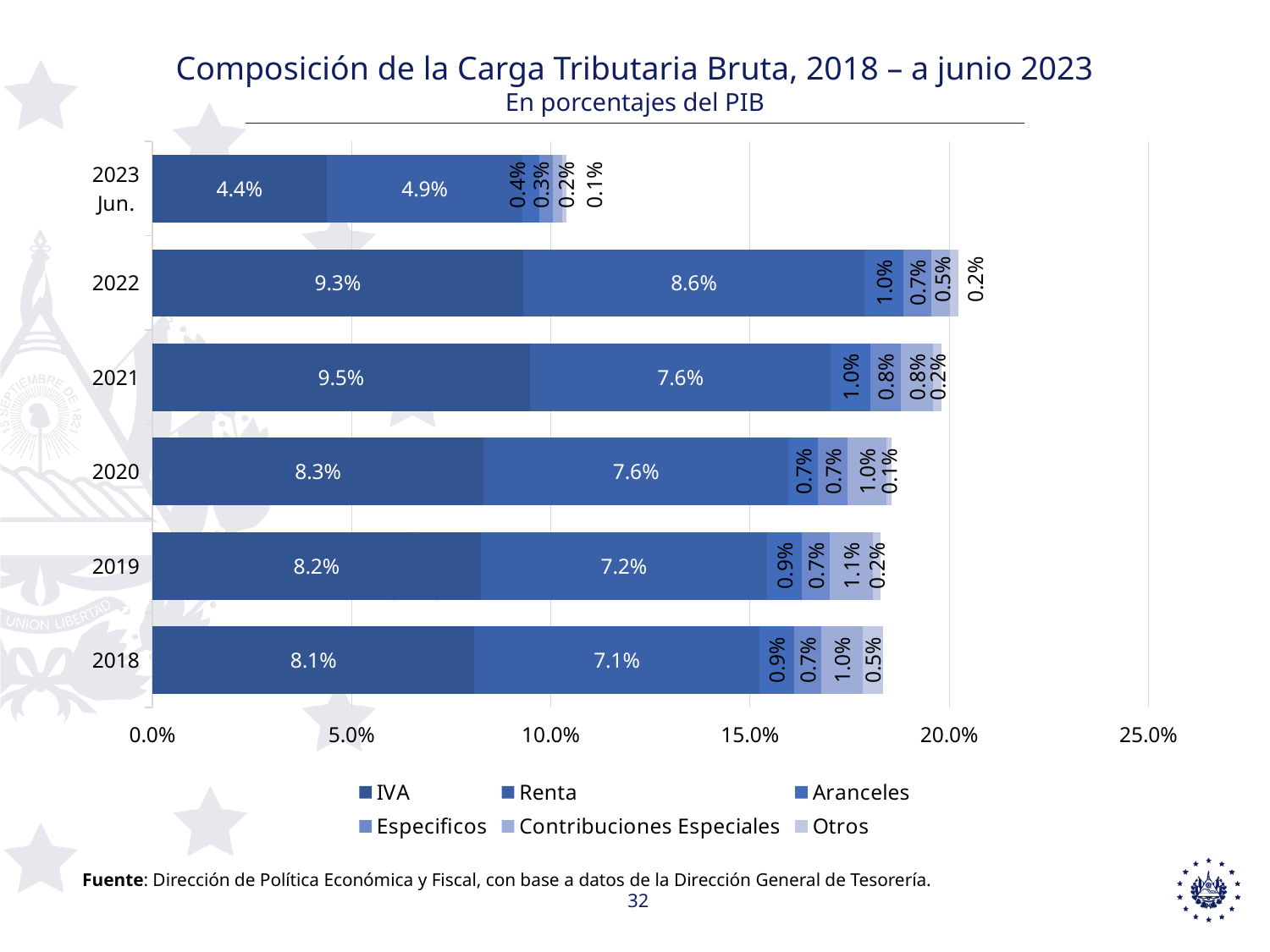
What is the total of the stacked bar for 2022? 20.3% Is the total of the stacked bar for 2020 greater or less than 20.0%? less What is the IVA value for 2022? 9.3% What is the Otros value for 2018? 0.5% Which is larger, the Renta value for 2022 or the Renta value for 2021? 2022 What is the difference between the IVA value for 2021 and the IVA value for 2022? 0.2 percentage points How many series does the legend list? 6 Which year has the highest IVA value? 2021 What kind of chart is shown on the slide? Stacked bar chart What is the Renta value for 2021? 7.6% Which period has the lowest IVA value? 2023 Jun. How many periods (bars) are shown on the chart? 6